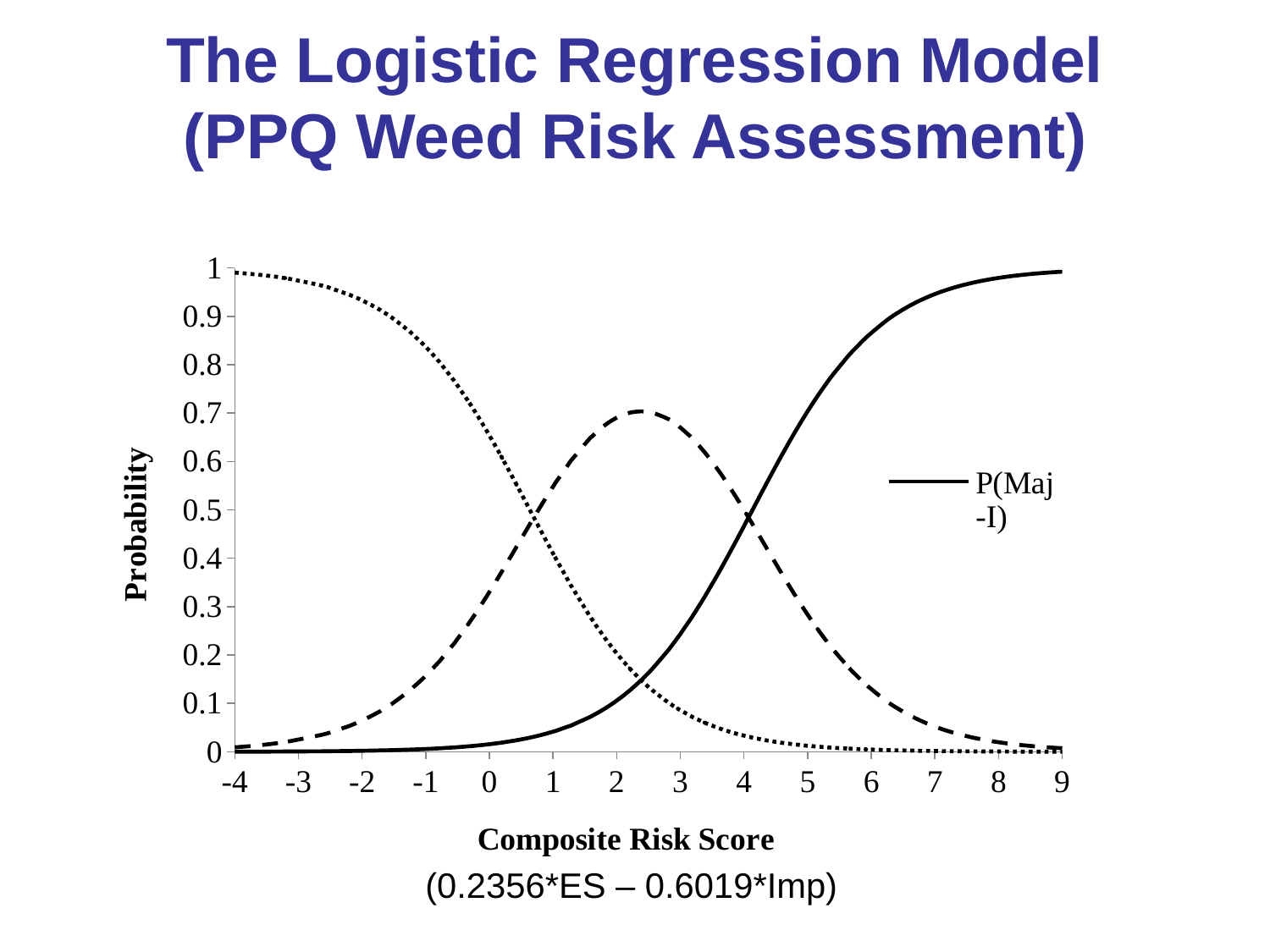
Does the P(Maj-I) line rise or fall as the Composite Risk Score increases? rise Which is larger for P(Maj-I): the value at a Composite Risk Score of 9 or at -4? 9 How many series does the legend list? 1 Is the value of P(Maj-I) at a Composite Risk Score of -4 greater or less than 0.1? less How many tick labels are shown on the x axis? 14 Is the value of P(Maj-I) at a Composite Risk Score of 2 greater or less than 0.3? less What is the label of the series listed in the legend? P(Maj-I) What is the label of the x axis? Composite Risk Score What kind of chart is shown on the slide? line chart Is the value of P(Maj-I) at a Composite Risk Score of 9 greater or less than 0.9? greater